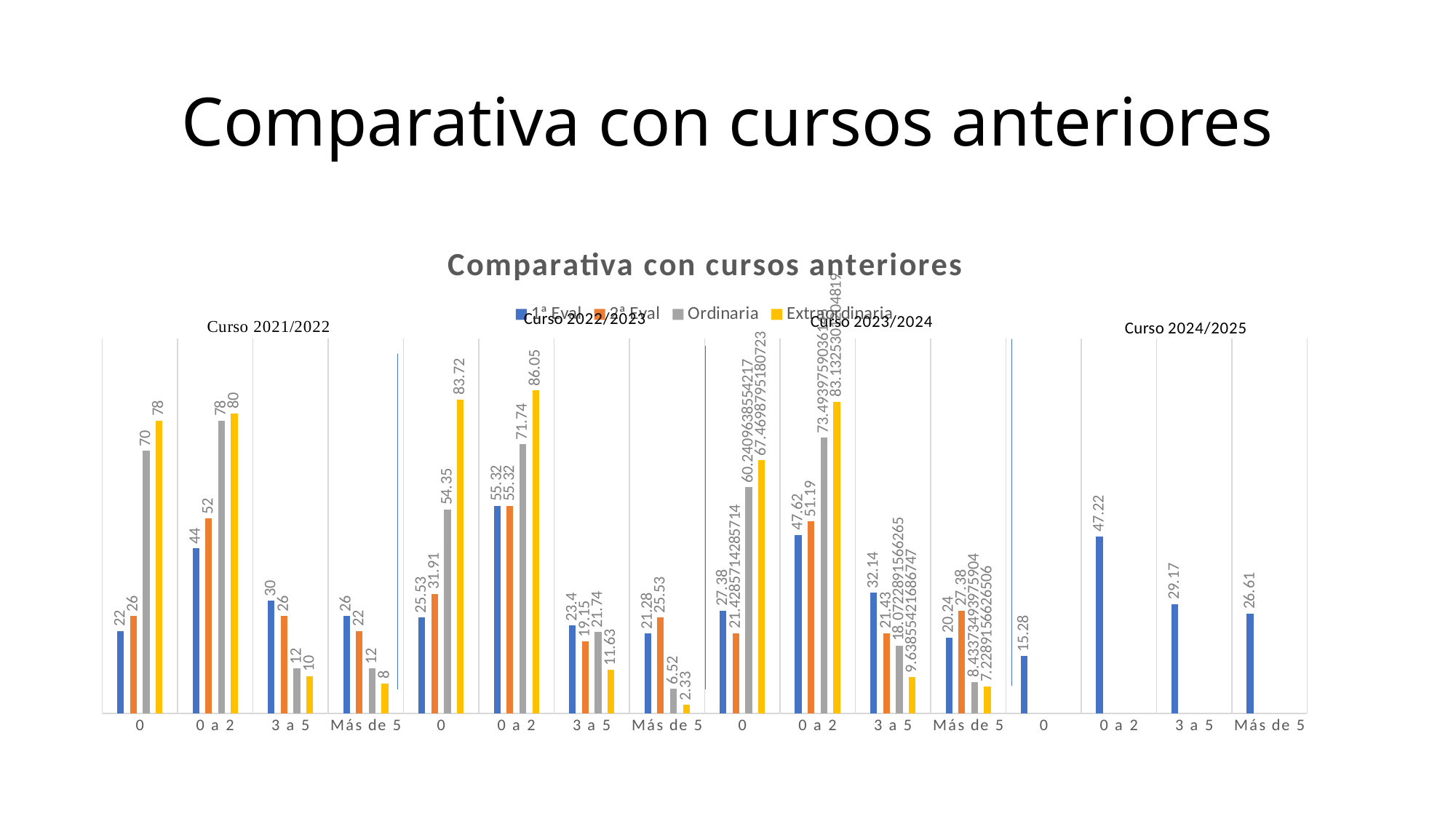
Which is larger for the '3 a 5' category in Curso 2022/2023: the 1ª Eval value or the 2ª Eval value? 1ª Eval What is the value of the 1ª Eval series for the '0' category in Curso 2024/2025? 15.28 What kind of chart is shown on the slide? Bar chart Which series has the lowest value for the 'Más de 5' category in Curso 2022/2023? Extraordinaria How many series does the legend list? 4 What is the value of the Ordinaria series for the '0' category in Curso 2022/2023? 54.35 What is the title of the chart? Comparativa con cursos anteriores Which series has the highest value for the '0 a 2' category in Curso 2022/2023? Extraordinaria What is the difference between the Extraordinaria and Ordinaria values for the '0' category in Curso 2021/2022? 8 What is the value of the 2ª Eval series for the 'Más de 5' category in Curso 2023/2024? 27.38 What is the value of the Extraordinaria series for the '0 a 2' category in Curso 2021/2022? 80 What is the value of the 1ª Eval series for the '0 a 2' category in Curso 2024/2025? 47.22